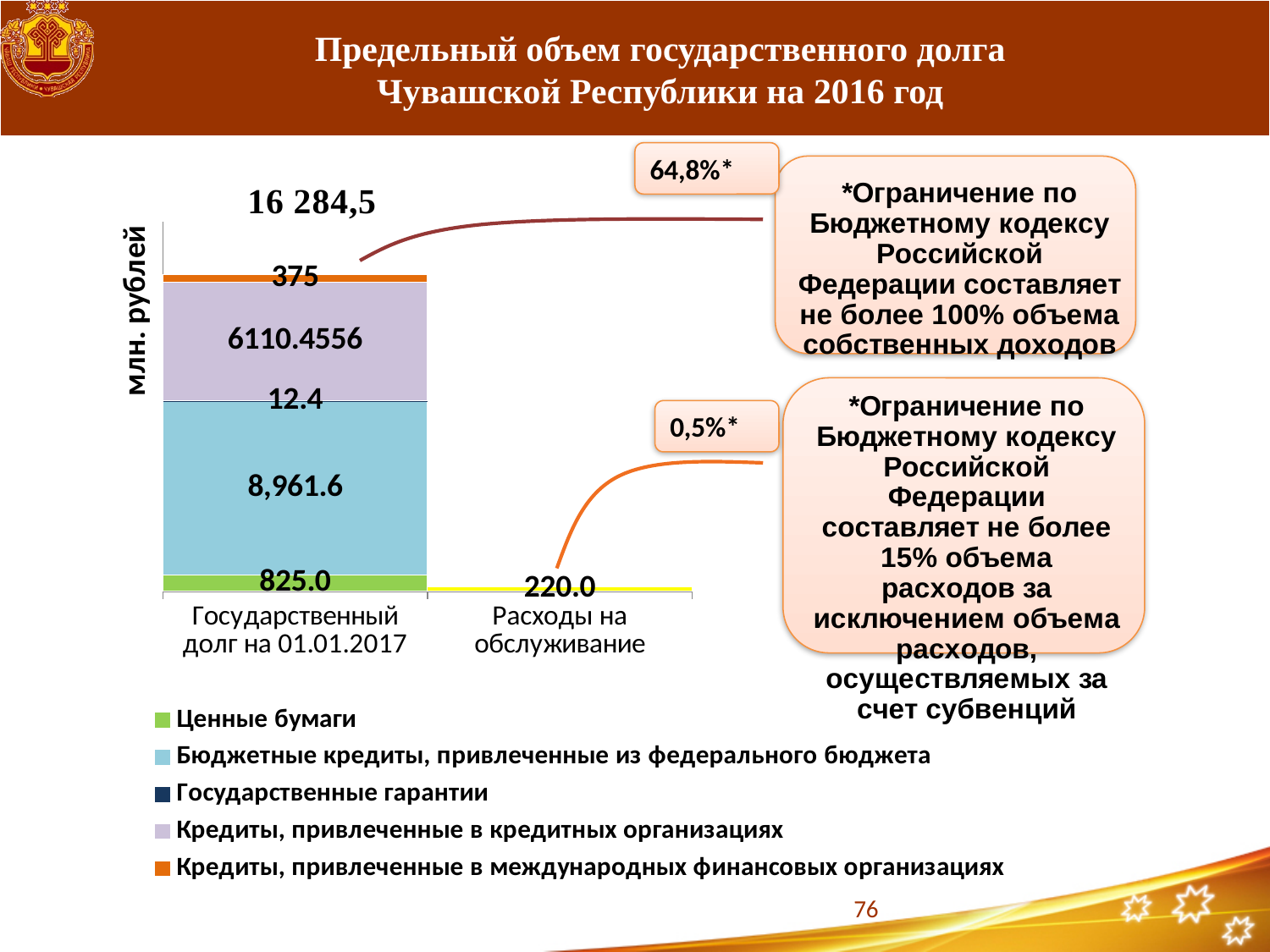
What is the value for Ценные бумаги in the Государственный долг на 01.01.2017 bar? 825.0 How many series does the legend list? 5 What is the value for Бюджетные кредиты, привлеченные из федерального бюджета in the Государственный долг на 01.01.2017 bar? 8,961.6 What is the value for Кредиты, привлеченные в международных финансовых организациях in the Государственный долг на 01.01.2017 bar? 375 How many categories are shown on the x axis? 2 What is the label of the y axis? млн. рублей What type of chart is shown on the slide? stacked bar chart What is the value shown for Расходы на обслуживание? 220.0 Which segment of the Государственный долг на 01.01.2017 bar is the largest? Бюджетные кредиты, привлеченные из федерального бюджета What is the value for Кредиты, привлеченные в кредитных организациях in the Государственный долг на 01.01.2017 bar? 6110.4556 What is the value for Государственные гарантии in the Государственный долг на 01.01.2017 bar? 12.4 What is the total of the Государственный долг на 01.01.2017 stacked bar as printed on the slide? 16 284,5